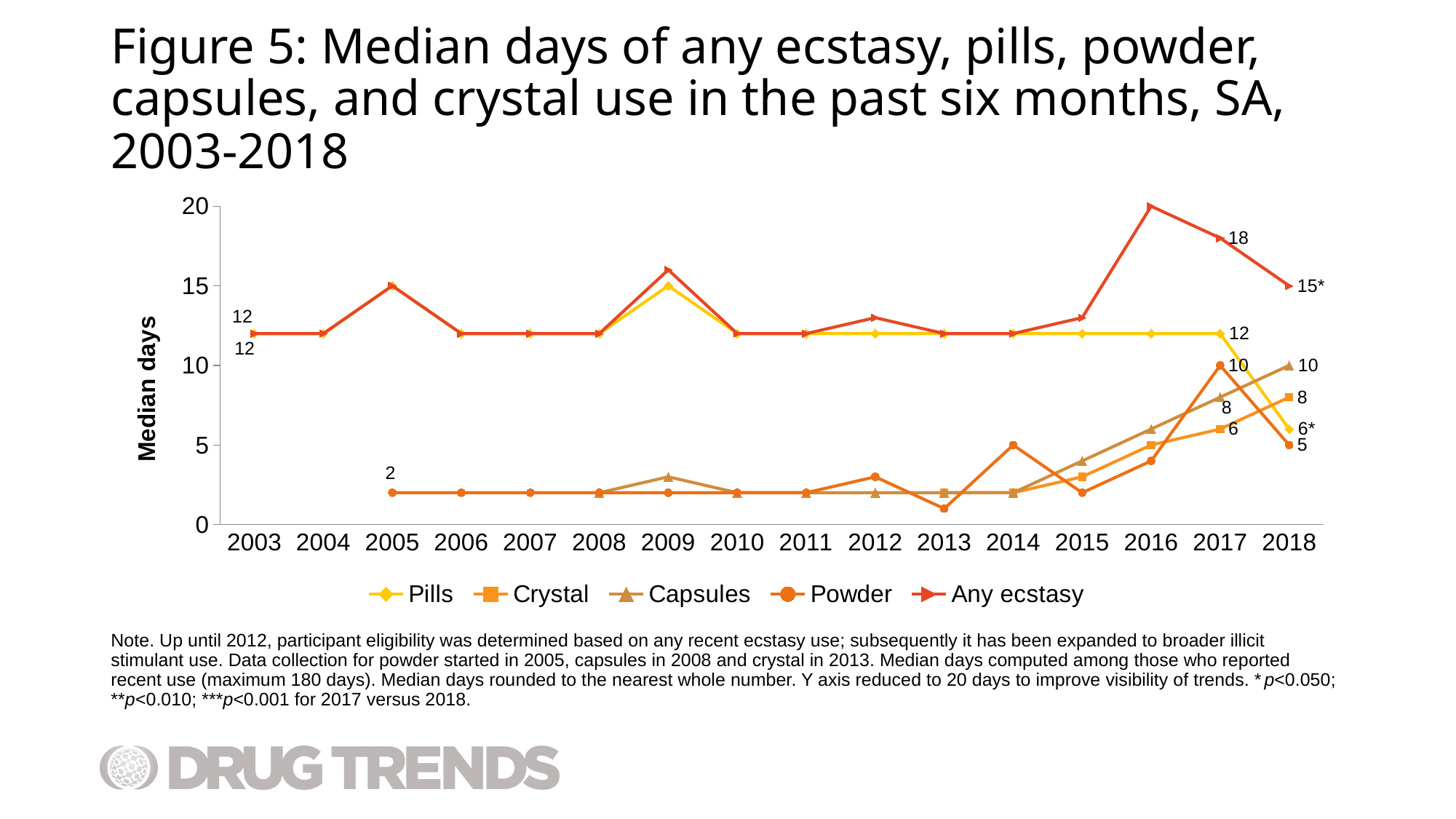
Which series has the lowest value in 2018? Powder In 2018, which is larger: Crystal or Powder? Crystal What is the value for Pills in 2018? 6* In which year does the Any ecstasy series reach its highest value? 2016 What is the difference between the Any ecstasy values for 2017 and 2018? 3 How many series does the legend list? 5 What is the value for Any ecstasy in 2017? 18 How many years are shown on the x axis? 16 What is the value for Crystal in 2017? 6 What is the value for Powder in 2005? 2 Is the value for Any ecstasy in 2009 greater or less than 15? greater What is the value for Capsules in 2018? 10